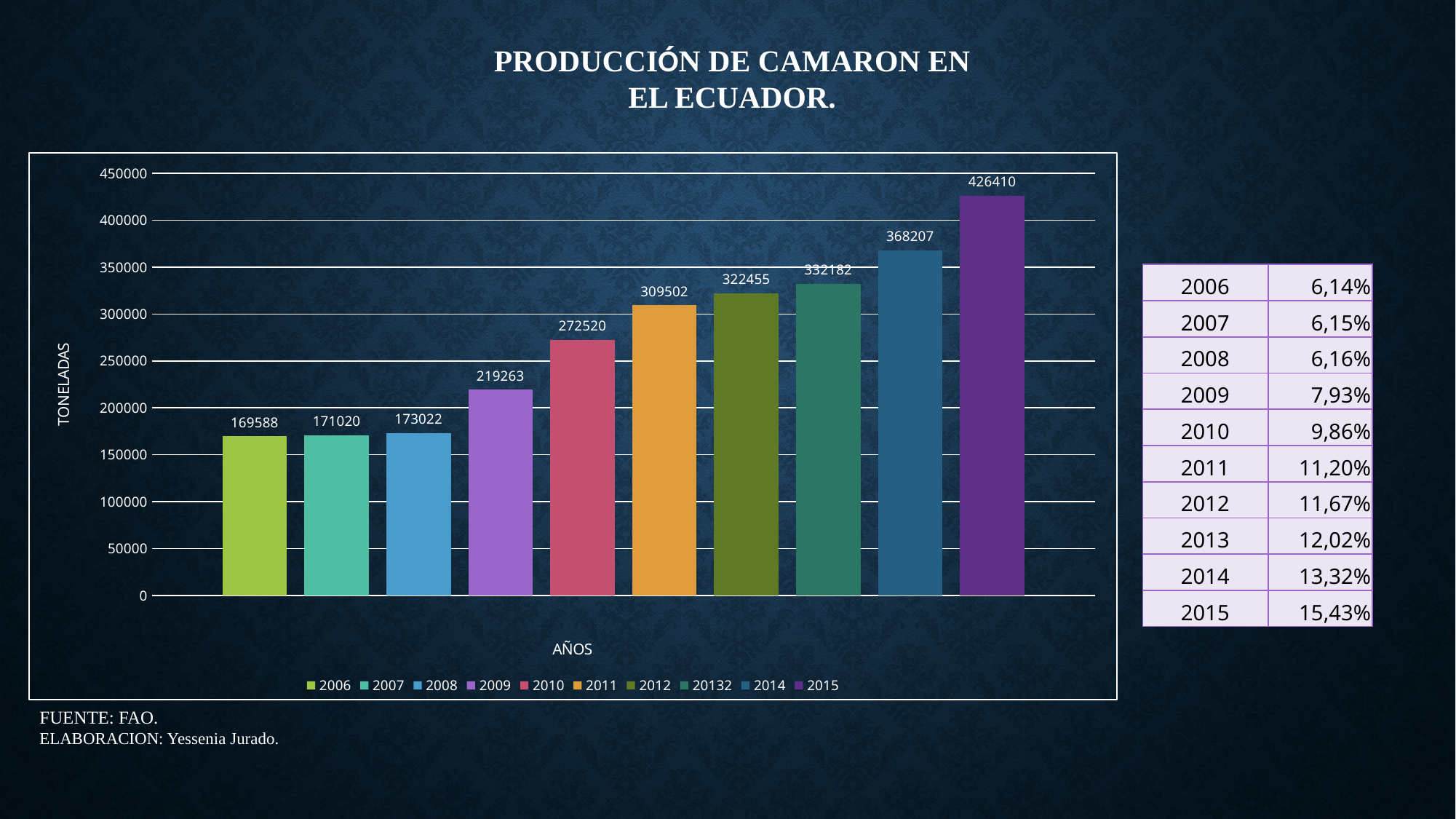
Is the value for 2014 greater or less than 350000? greater Which year has the lowest production? 2006 What is the production value shown for 2011? 309502 Which year has the highest production? 2015 Do the production values rise or fall from 2006 to 2015? rise What is the difference between the production values for 2015 and 2014? 58203 What is the production value shown for 2009? 219263 Which is larger, the production for 2012 or for 2010? 2012 What is the production value shown for 2015? 426410 How many bars are plotted in the chart? 10 What kind of chart is shown on the slide? bar chart What is the difference between the production values for 2010 and 2009? 53257